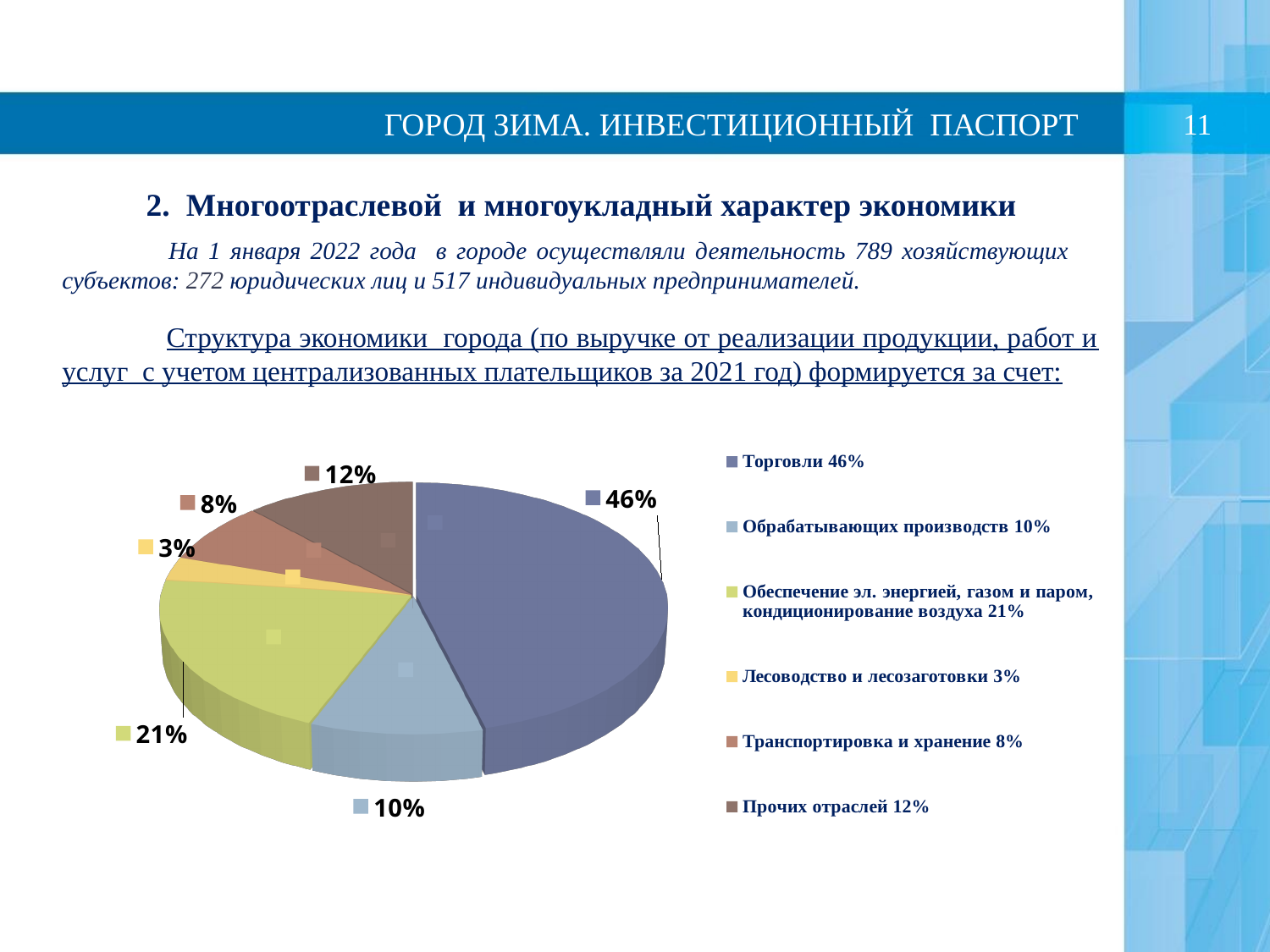
What share of the pie does Обеспечение эл. энергией, газом и паром, кондиционирование воздуха account for? 21% What share of the pie does Прочих отраслей account for? 12% How many categories does the legend of the pie chart list? 6 What share of the pie does Торговли account for? 46% Which category has the largest slice of the pie? Торговли What kind of chart is shown on the slide? pie chart Which category has the smallest slice of the pie? Лесоводство и лесозаготовки What is the difference in percentage points between Торговли and Обеспечение эл. энергией, газом и паром, кондиционирование воздуха? 25 Which is larger, the share for Прочих отраслей or the share for Транспортировка и хранение? Прочих отраслей